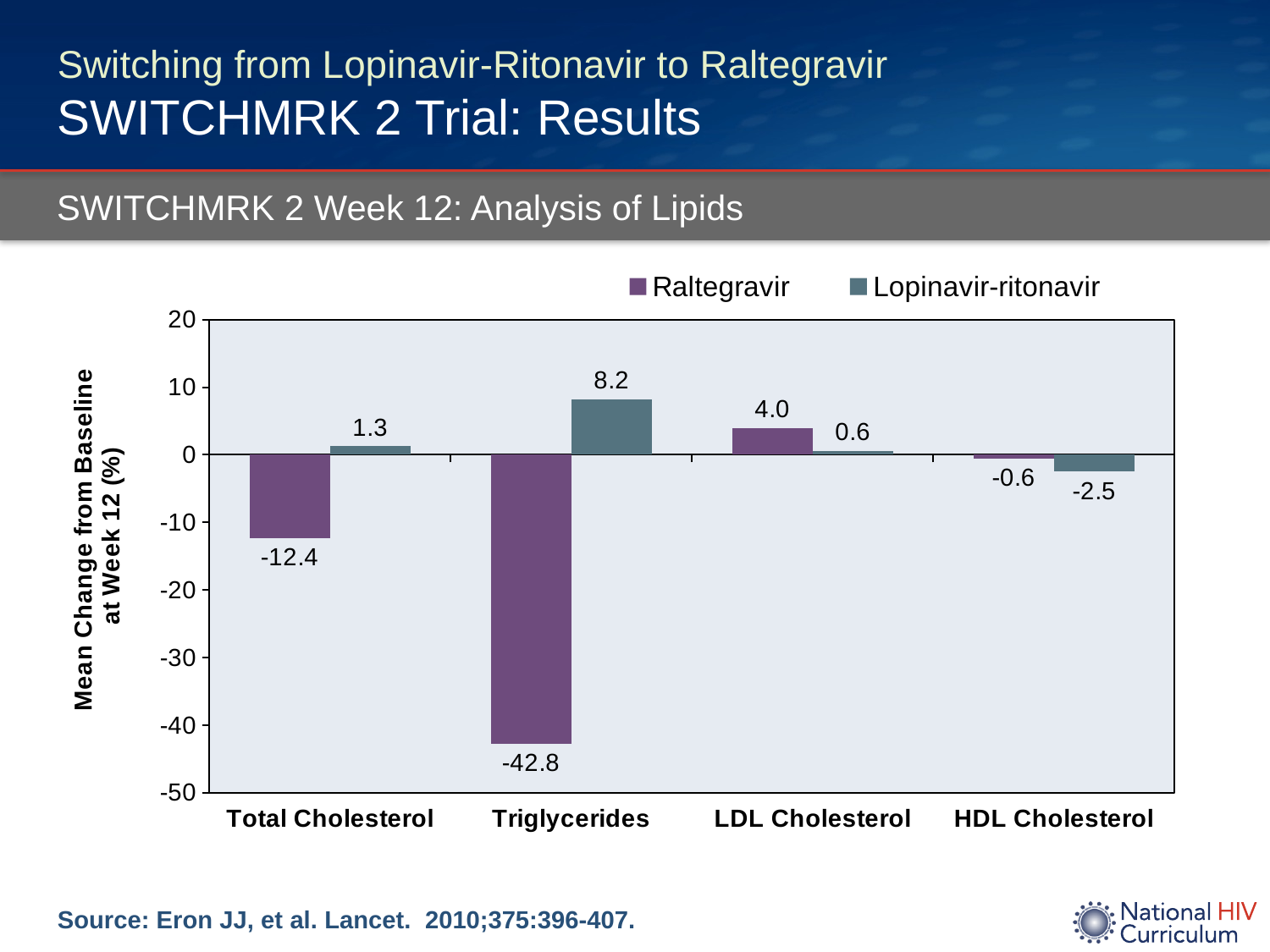
What kind of chart is shown on the slide? Bar chart What is the label of the y axis? Mean Change from Baseline at Week 12 (%) What is the mean change from baseline for Lopinavir-ritonavir in Triglycerides? 8.2 How many lipid categories are shown on the x axis? 4 What is the difference between the Lopinavir-ritonavir and Raltegravir values for Triglycerides? 51.0 Which is larger for LDL Cholesterol, the Raltegravir value or the Lopinavir-ritonavir value? Raltegravir Which lipid category has the lowest value for Raltegravir? Triglycerides What is the value for Lopinavir-ritonavir in HDL Cholesterol? -2.5 What is the mean change from baseline for Raltegravir in Total Cholesterol? -12.4 What is the value for Raltegravir in LDL Cholesterol? 4.0 How many series does the legend list? 2 Which lipid category has the highest value for Lopinavir-ritonavir? Triglycerides